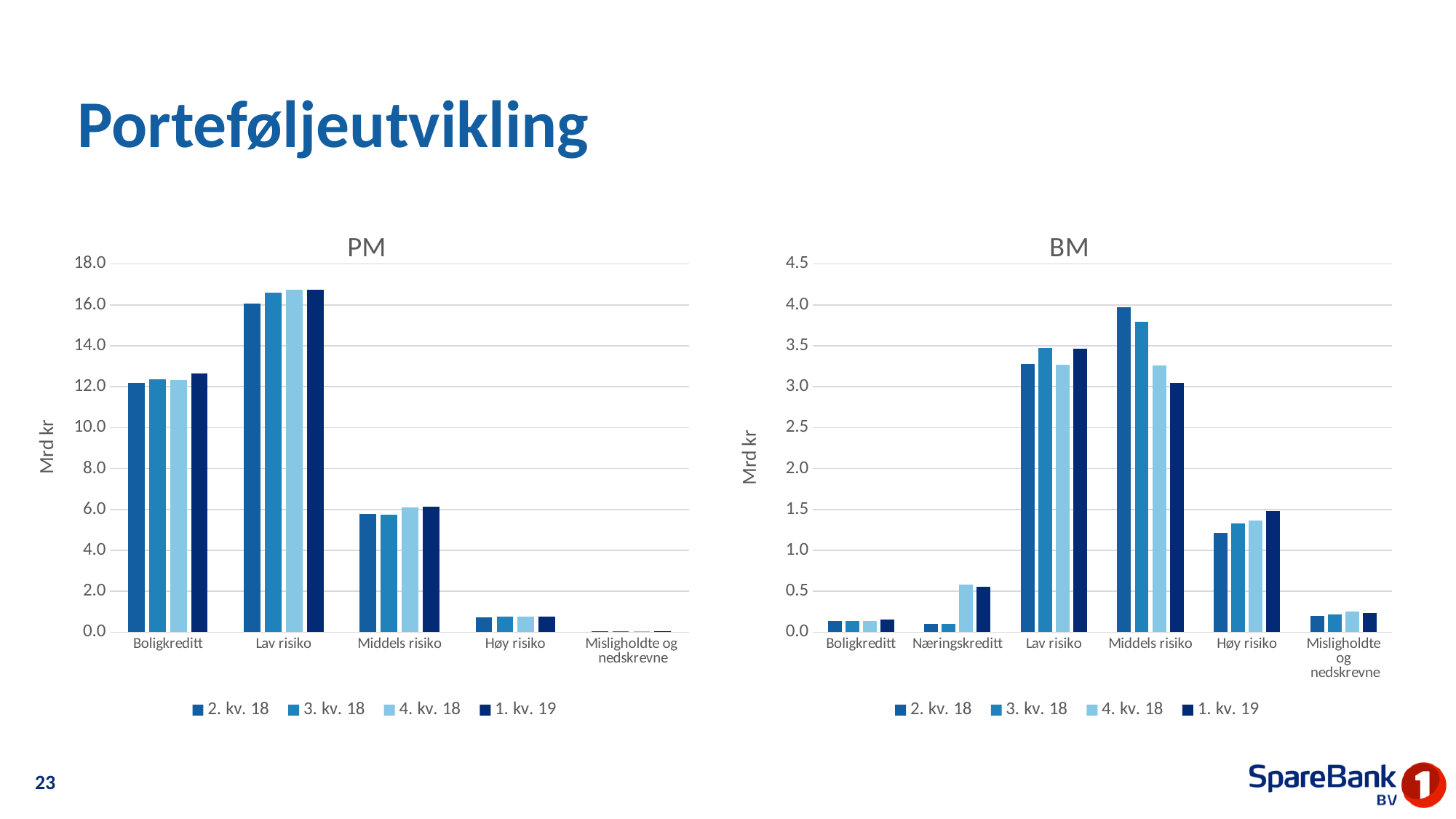
On the PM chart, what kind of chart is shown? bar chart On the BM chart, which category has the highest value for 2. kv. 18? Middels risiko On the BM chart, do the values for Middels risiko rise or fall from 2. kv. 18 to 1. kv. 19? fall On the PM chart, which category has the highest value for 1. kv. 19? Lav risiko On the BM chart, how many categories are shown on the x axis? 6 On the PM chart, how many series does the legend list? 4 On the PM chart, which category has the lowest value for 2. kv. 18? Misligholdte og nedskrevne On the BM chart, what is the label on the y axis? Mrd kr On the PM chart, is the value for Boligkreditt in 1. kv. 19 greater or less than 12.0? greater On the BM chart, is the value for Lav risiko in 1. kv. 19 greater or less than 3.0? greater On the PM chart, how many categories are shown on the x axis? 5 On the BM chart, which is larger for 1. kv. 19: Lav risiko or Middels risiko? Lav risiko